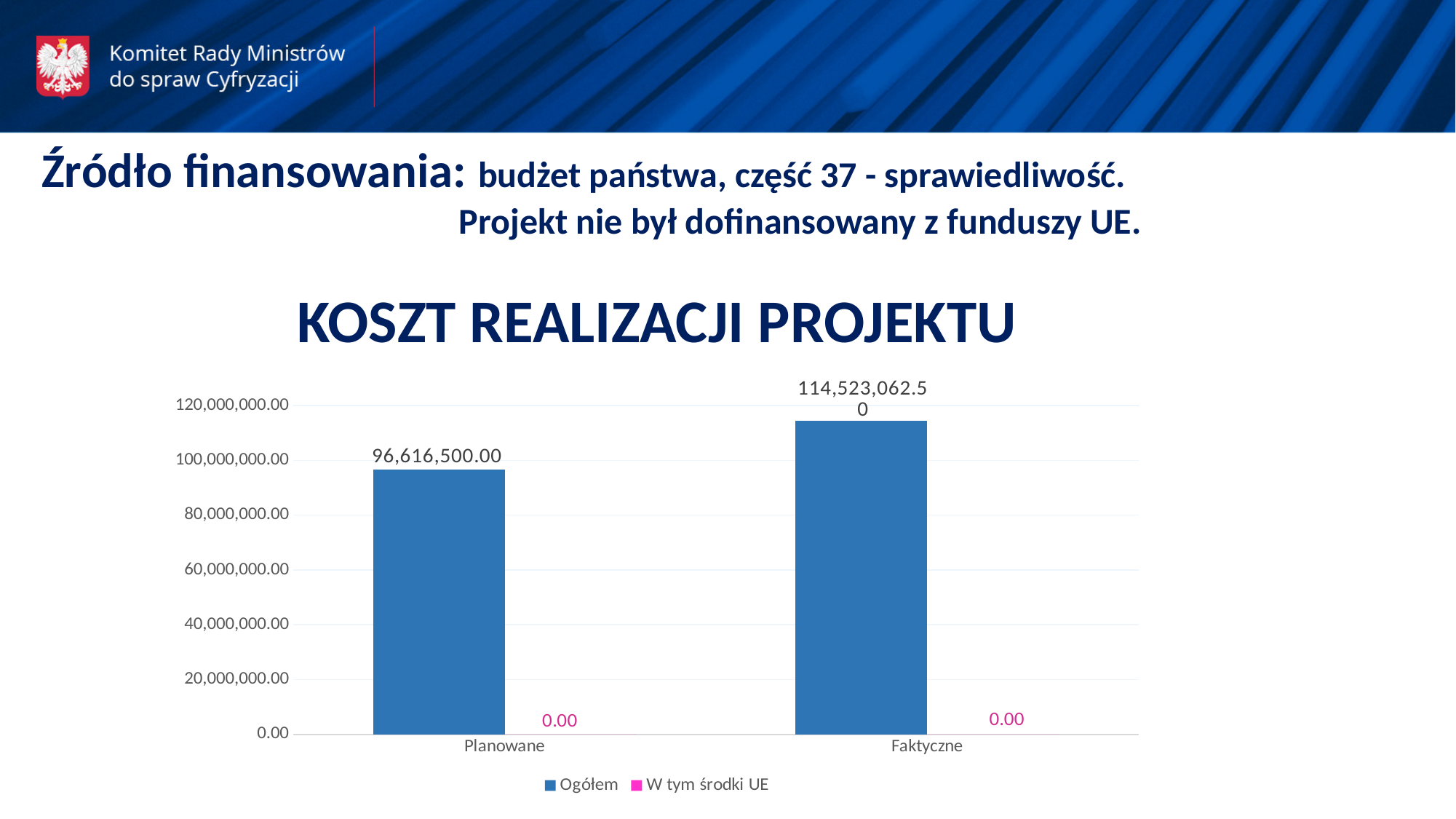
What is the title of the chart? KOSZT REALIZACJI PROJEKTU What type of chart is shown on the slide? bar chart What is the Ogółem value for Faktyczne? 114,523,062.50 How many series does the legend list? 2 Which category has the lower Ogółem value? Planowane How many categories are shown on the x axis? 2 What is the difference between the Ogółem values for Faktyczne and Planowane? 17,906,562.50 Is the Ogółem value for Planowane greater or less than 100,000,000.00? less What is the W tym środki UE value for Faktyczne? 0.00 What is the Ogółem value for Planowane? 96,616,500.00 What is the W tym środki UE value for Planowane? 0.00 Which category has the higher Ogółem value? Faktyczne